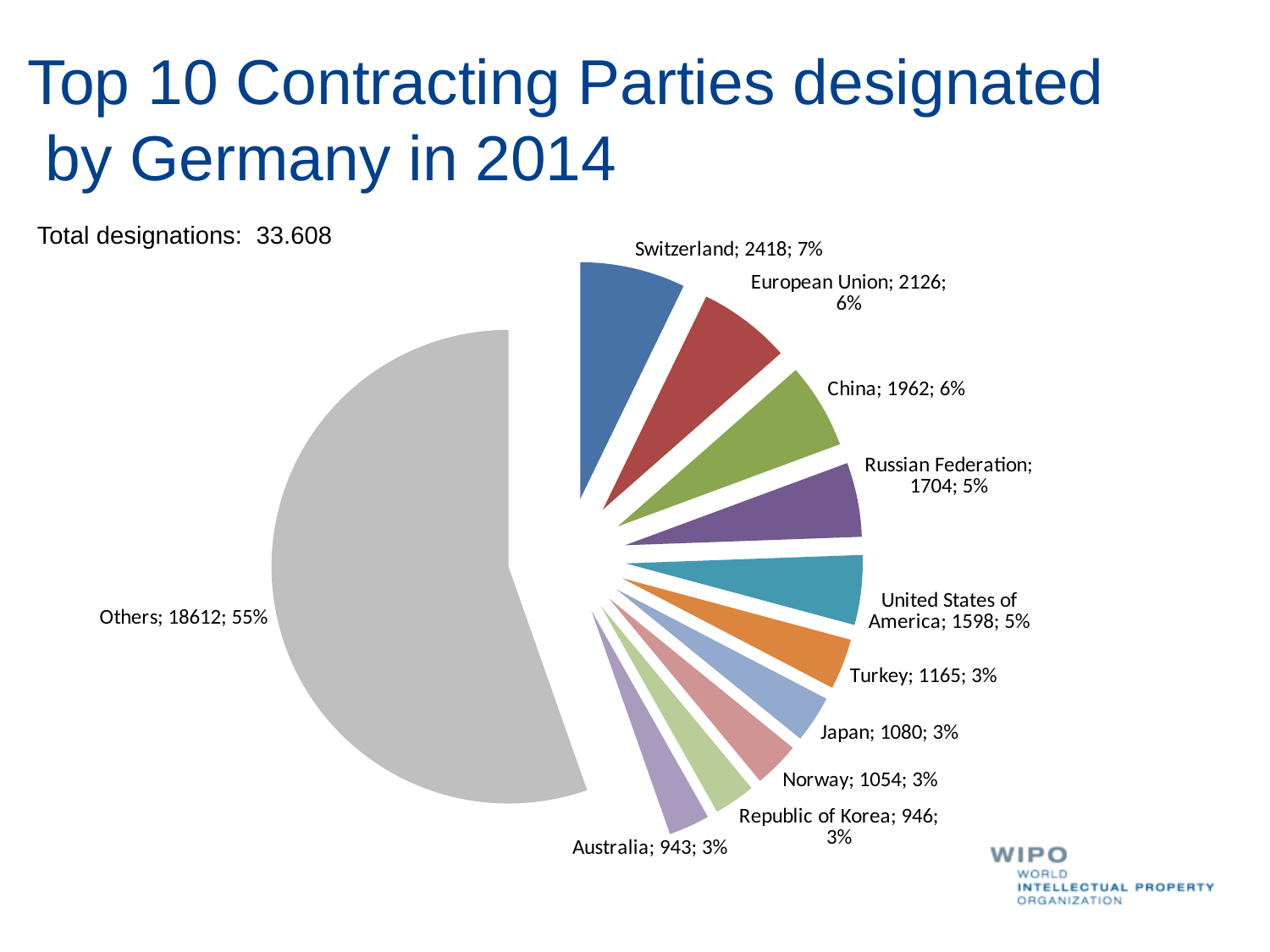
What percentage share does the Others slice have? 55% What is the value shown for the Russian Federation? 1704 What total number of designations is stated on the slide? 33.608 Which of the named contracting parties (excluding Others) has the largest slice? Switzerland Which slice has the smallest value? Australia What kind of chart is shown on the slide? pie chart What percentage share is shown for the United States of America? 5% How many designations does the slice for Switzerland represent? 2418 What is the difference between the values for Norway and the Republic of Korea? 108 What is the difference between the values for Switzerland and the European Union? 292 How many slices does the pie chart have? 11 Which has a larger value, Turkey or Japan? Turkey